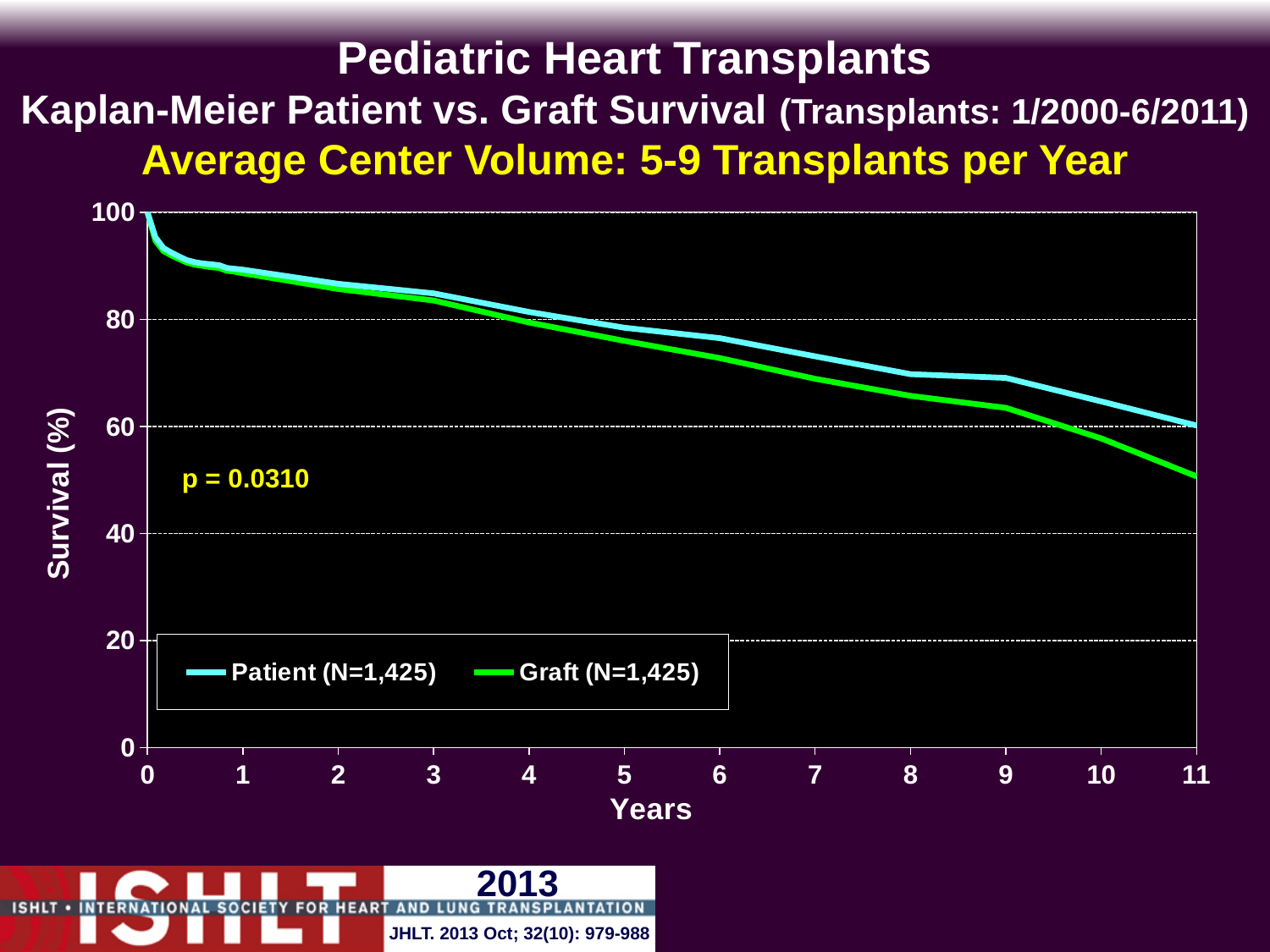
At year 11, which curve is lower, Patient or Graft? Graft What is the highest year value shown on the x axis? 11 At year 9, which curve is higher, Patient or Graft? Patient Is the Patient survival at year 8 greater or less than 80? less What kind of chart is shown on the slide? line chart Is the Graft survival at year 11 greater or less than 60? less What is the p-value shown on the chart? p = 0.0310 Do the survival curves rise or fall as years increase? fall Is the Graft survival at year 1 greater or less than 80? greater What is the N for the Patient series in the legend? N=1,425 How many series does the legend list? 2